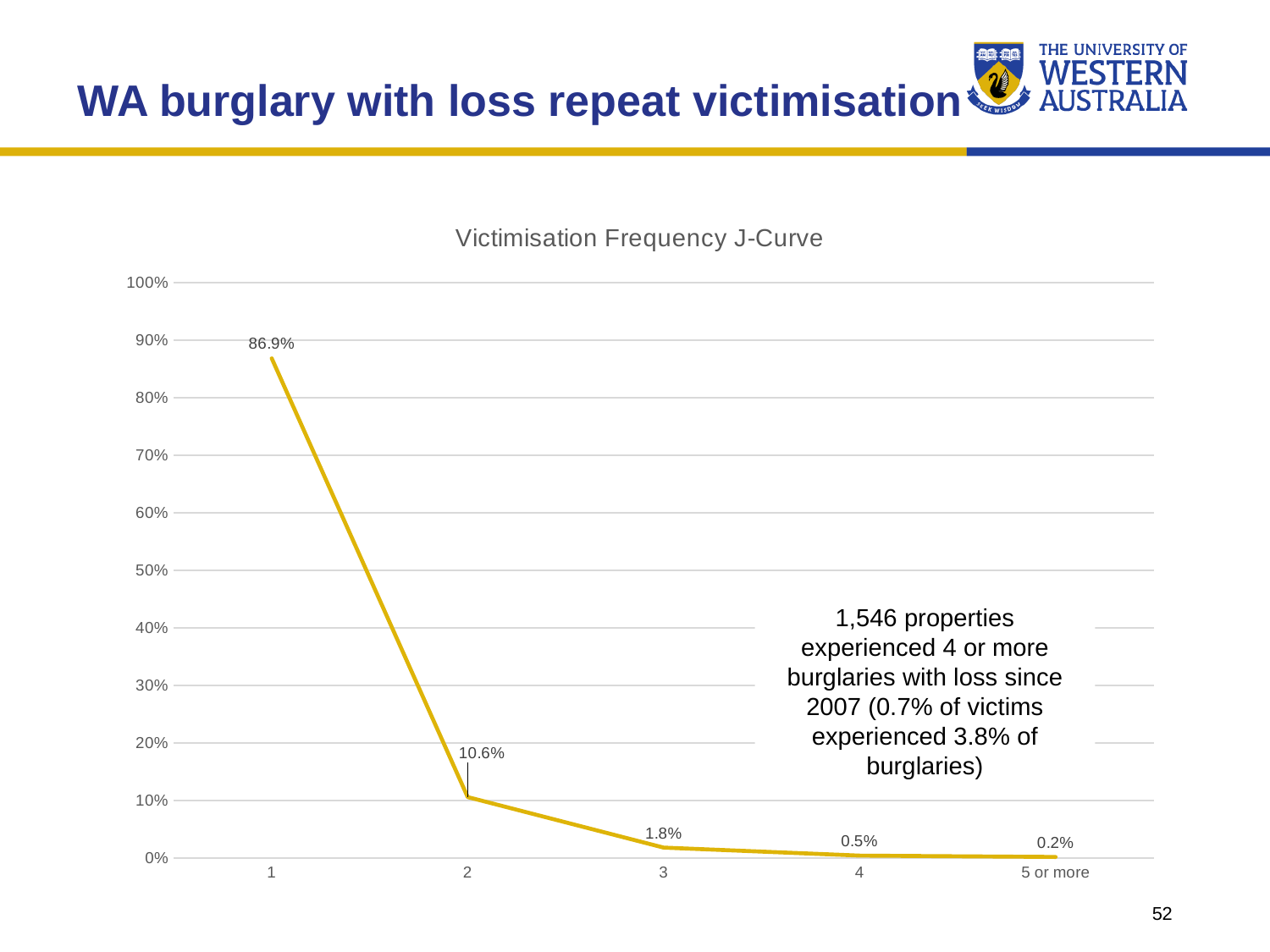
What is the value for category 1 in the Victimisation Frequency J-Curve chart? 86.9% Which category has the lowest value in the chart? 5 or more Do the values rise or fall along the x axis from category 1 to '5 or more'? fall Which category has the highest value in the chart? 1 What is the value for category 3 in the chart? 1.8% Which is larger, the value for category 3 or the value for category 4? 3 What kind of chart is shown on the slide? line chart What is the difference between the values for category 1 and category 2? 76.3% Is the value for category 1 greater or less than 80%? greater What is the value for the '5 or more' category? 0.2% How many categories are plotted on the x axis? 5 What is the value for category 2 in the chart? 10.6%